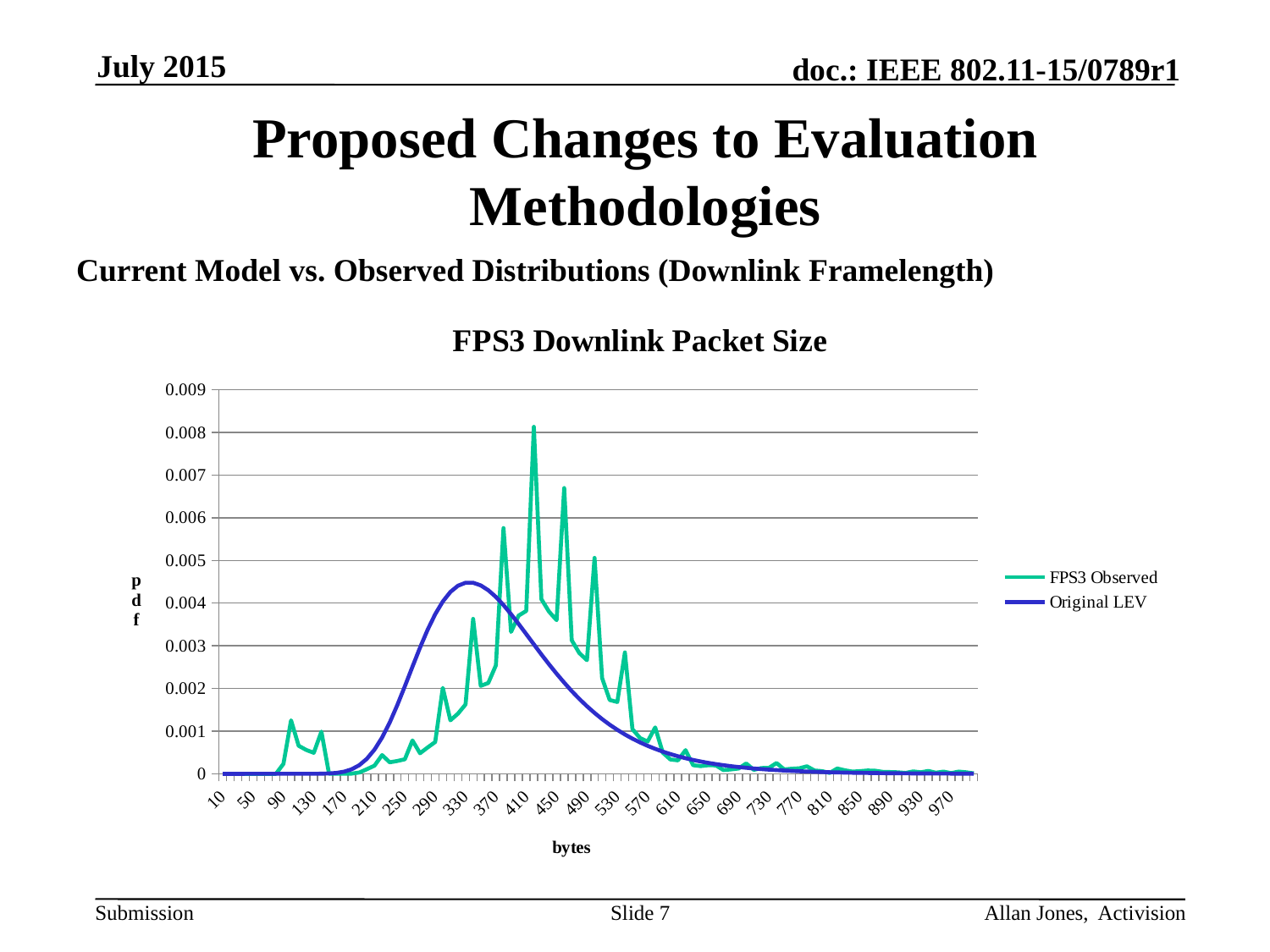
At 250 bytes, which series has the higher value, FPS3 Observed or Original LEV? Original LEV What is the label of the x axis? bytes Does the Original LEV series rise or fall between 570 and 970 bytes? fall Which series reaches the higher peak value, FPS3 Observed or Original LEV? FPS3 Observed Is the value of the Original LEV series at 10 bytes greater or less than 0.001? less Is the peak value of the Original LEV series greater or less than 0.005? less Is the peak value of the FPS3 Observed series greater or less than 0.007? greater At 450 bytes, which series has the higher value, FPS3 Observed or Original LEV? FPS3 Observed What kind of chart is shown on the slide? line chart How many series does the legend list? 2 What is the title of the chart? FPS3 Downlink Packet Size